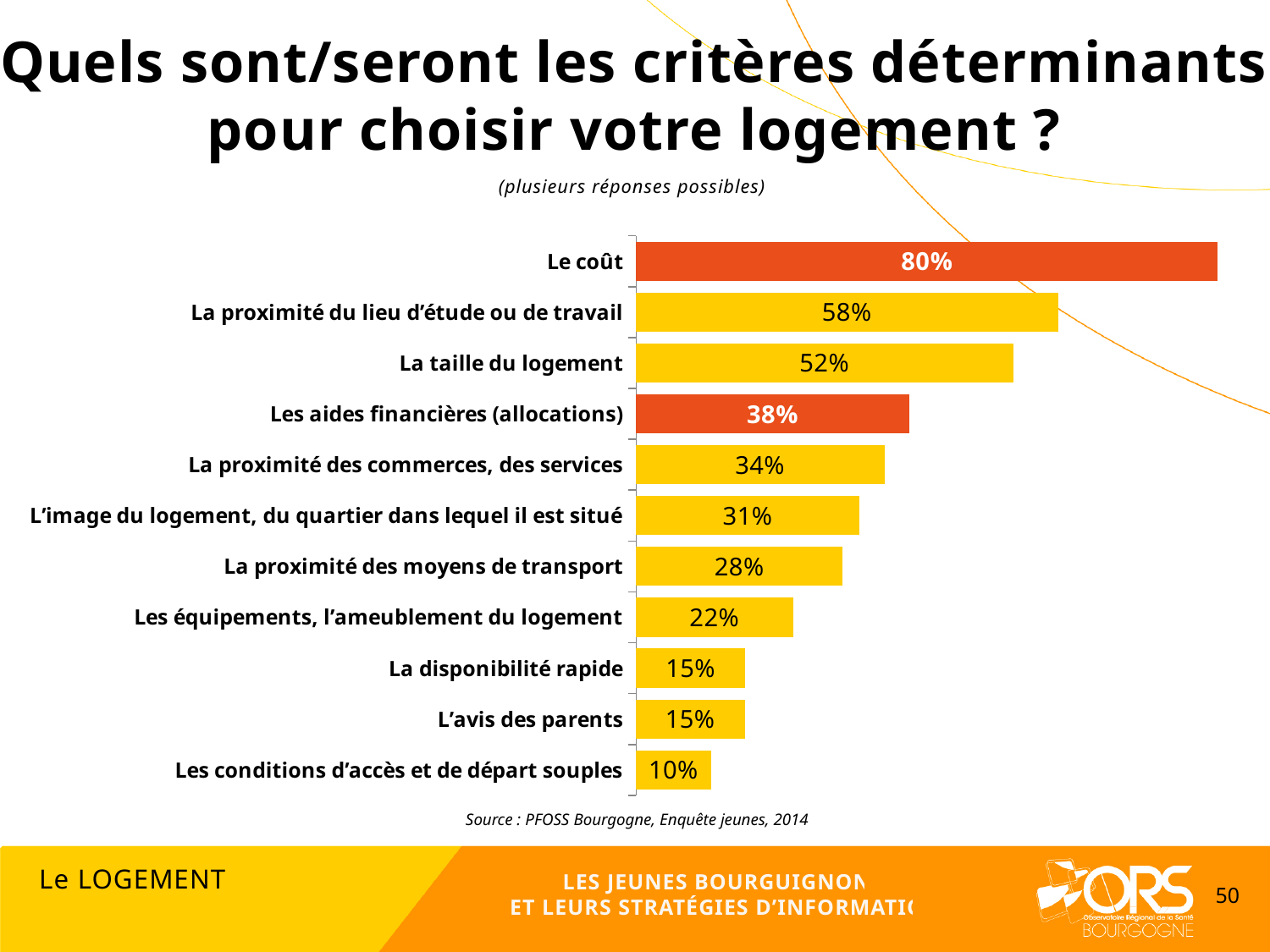
Which two criteria share the same value of 15%? La disponibilité rapide and L'avis des parents How many criteria are shown in the chart? 11 Which bars are coloured orange-red rather than yellow? Le coût and Les aides financières (allocations) What is the difference between "Le coût" and "La proximité du lieu d'étude ou de travail"? 22% What percentage is shown for "Le coût"? 80% What is the difference between "La taille du logement" and "Les équipements, l'ameublement du logement"? 30% What kind of chart is shown on the slide? Bar chart Which is larger: "La proximité des commerces, des services" or "L'image du logement, du quartier dans lequel il est situé"? La proximité des commerces, des services Which criterion has the highest percentage? Le coût Which criterion has the lowest percentage? Les conditions d'accès et de départ souples What percentage is shown for "Les aides financières (allocations)"? 38% What is the value for "La proximité des moyens de transport"? 28%